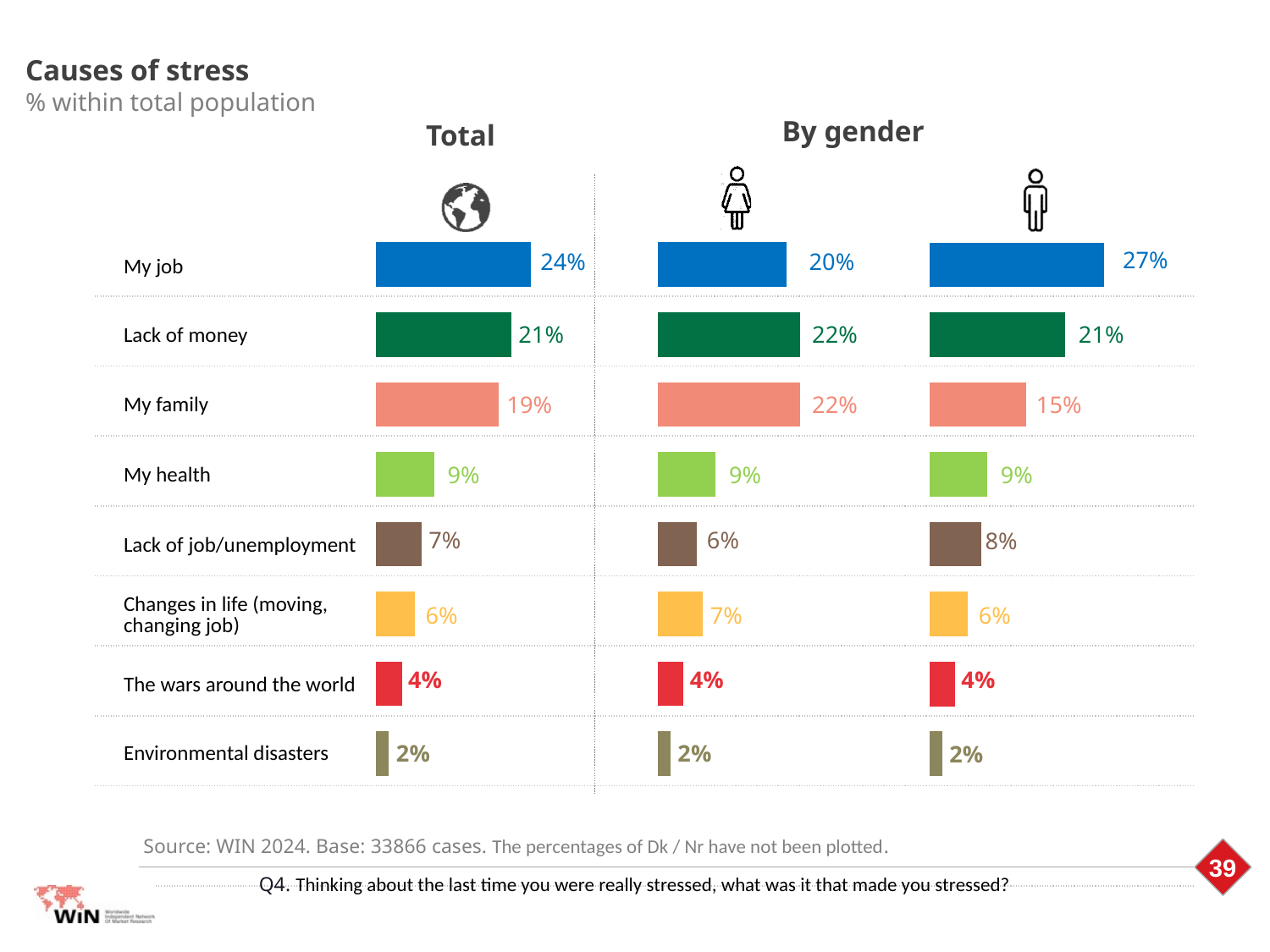
In the By gender chart, what is the value for 'My family' among men (male icon column)? 15% In the By gender chart, what is the value for 'My job' among women (female icon column)? 20% What is the title of the slide's chart? Causes of stress In the Total chart, which cause of stress has the highest value? My job In the Total chart, which cause of stress has the lowest value? Environmental disasters What type of chart is used to show the causes of stress on this slide? Bar chart How many causes of stress are listed in the Total chart? 8 In the Total chart, what is the difference between 'My job' and 'My family'? 5% In the Total chart, what percentage of people cite 'My job' as a cause of stress? 24% In the Total chart, what is the value for 'Lack of money'? 21% In the By gender chart, is the value for 'My family' larger for women or for men? Women In the By gender chart, what is the difference between men's and women's values for 'My job'? 7%